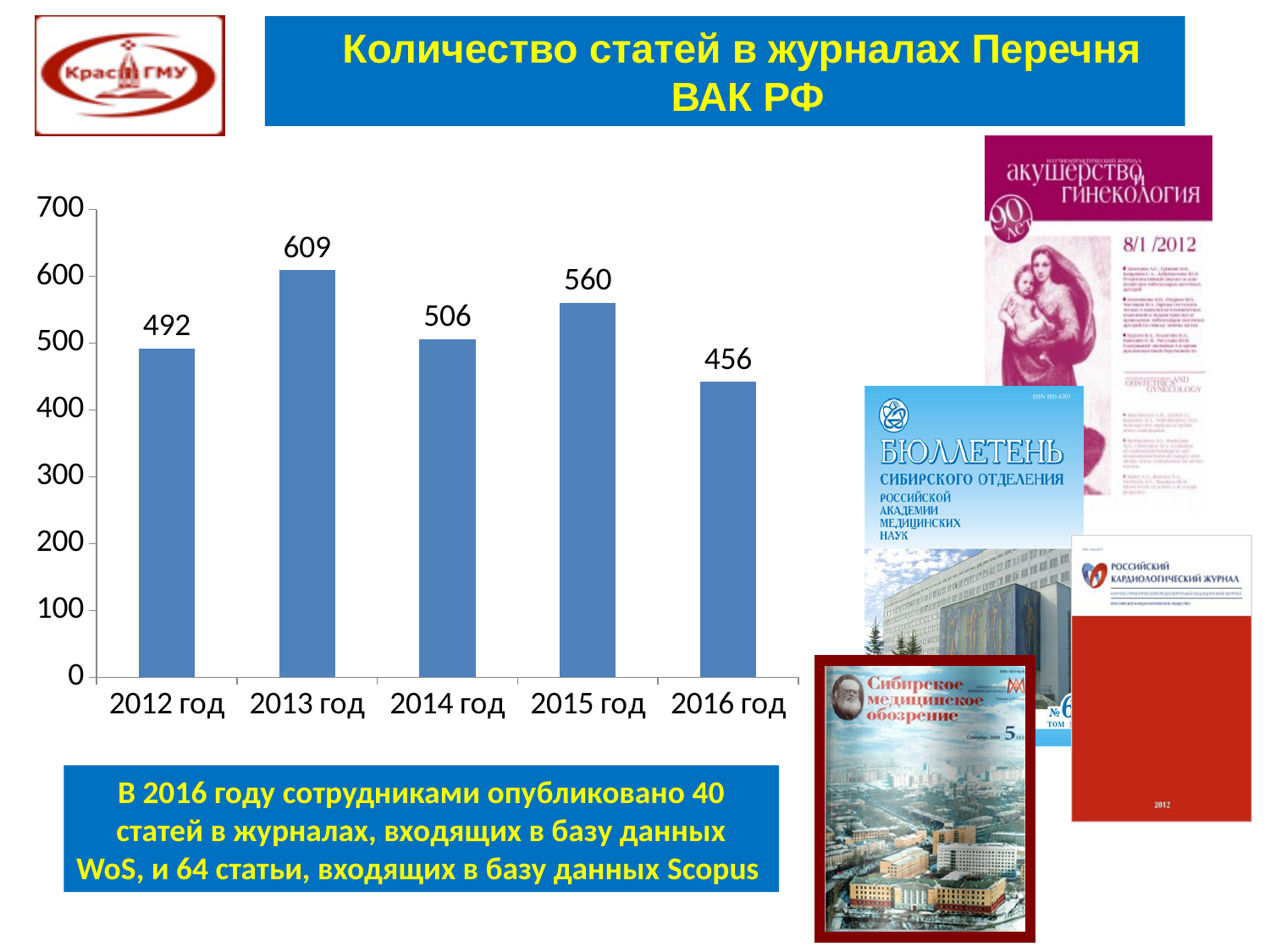
What is the value for 2012 год? 492 Which year has the lowest value? 2016 год How many years are shown on the x axis? 5 What is the value for 2016 год? 456 Is the value for 2015 год greater or less than 500? greater What is the title of the slide? Количество статей в журналах Перечня ВАК РФ What is the difference between the values for 2013 год and 2016 год? 153 Which is larger, the value for 2015 год or the value for 2014 год? 2015 год What is the value for 2013 год? 609 What kind of chart is shown on the slide? bar chart Which year has the highest value? 2013 год What is the value for 2014 год? 506